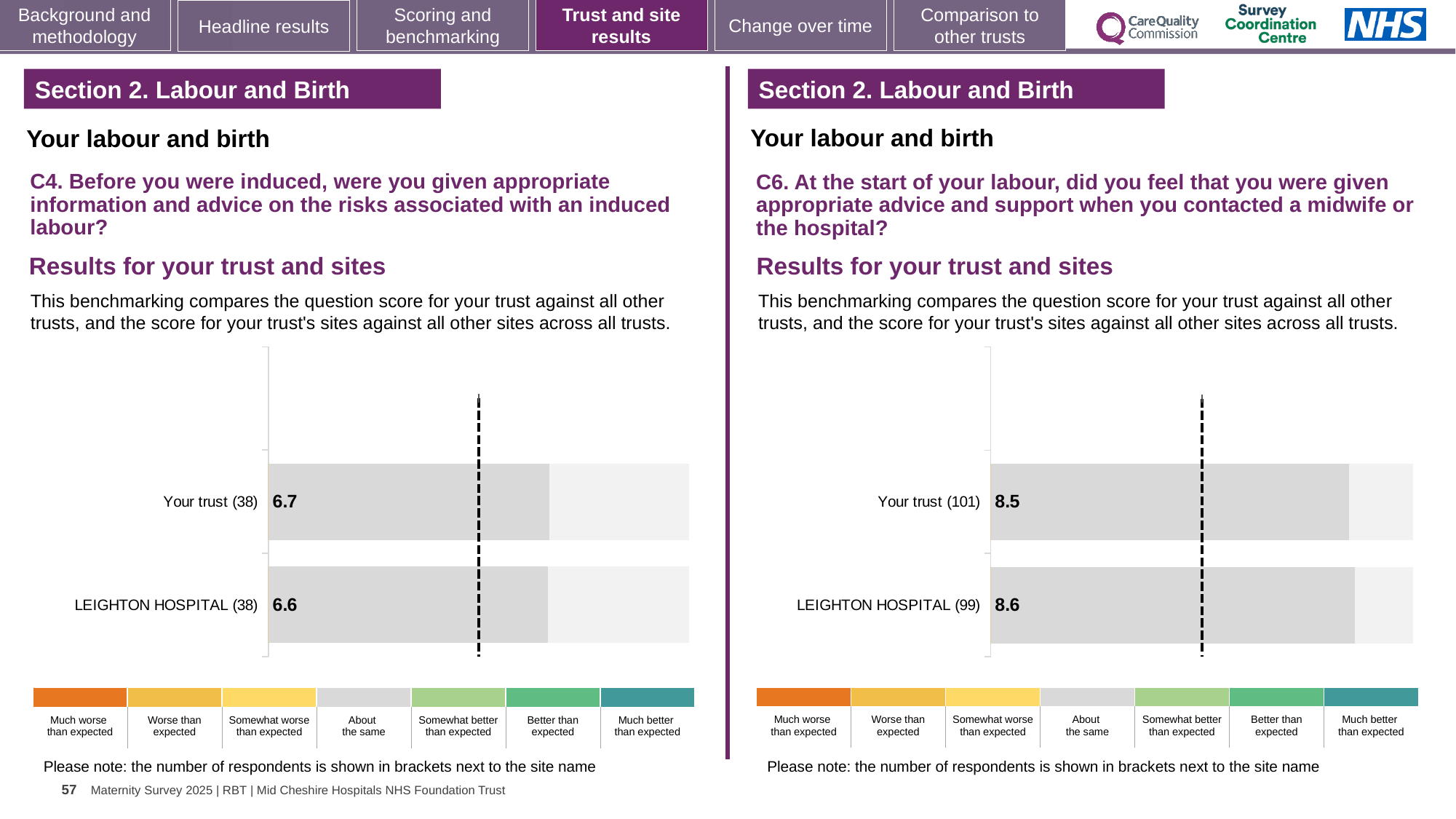
On the right chart (C6), what is the difference between the LEIGHTON HOSPITAL score and the Your trust score? 0.1 On the left chart (C4), how many respondents are shown in brackets for Your trust? 38 On the right chart (C6), what is the score for Your trust? 8.5 On the right chart (C6), which has the higher score, Your trust or LEIGHTON HOSPITAL? LEIGHTON HOSPITAL On the left chart (C4), what is the difference between the Your trust score and the LEIGHTON HOSPITAL score? 0.1 On the right chart (C6), what is the score for LEIGHTON HOSPITAL? 8.6 How many bars are plotted on the left chart (C4)? 2 On the left chart (C4), which has the higher score, Your trust or LEIGHTON HOSPITAL? Your trust What kind of chart is used on the right (C6) to show the results for your trust and sites? Bar chart On the left chart (C4), what is the score for Your trust? 6.7 On the left chart (C4), what is the score for LEIGHTON HOSPITAL? 6.6 On the right chart (C6), how many respondents are shown in brackets for LEIGHTON HOSPITAL? 99